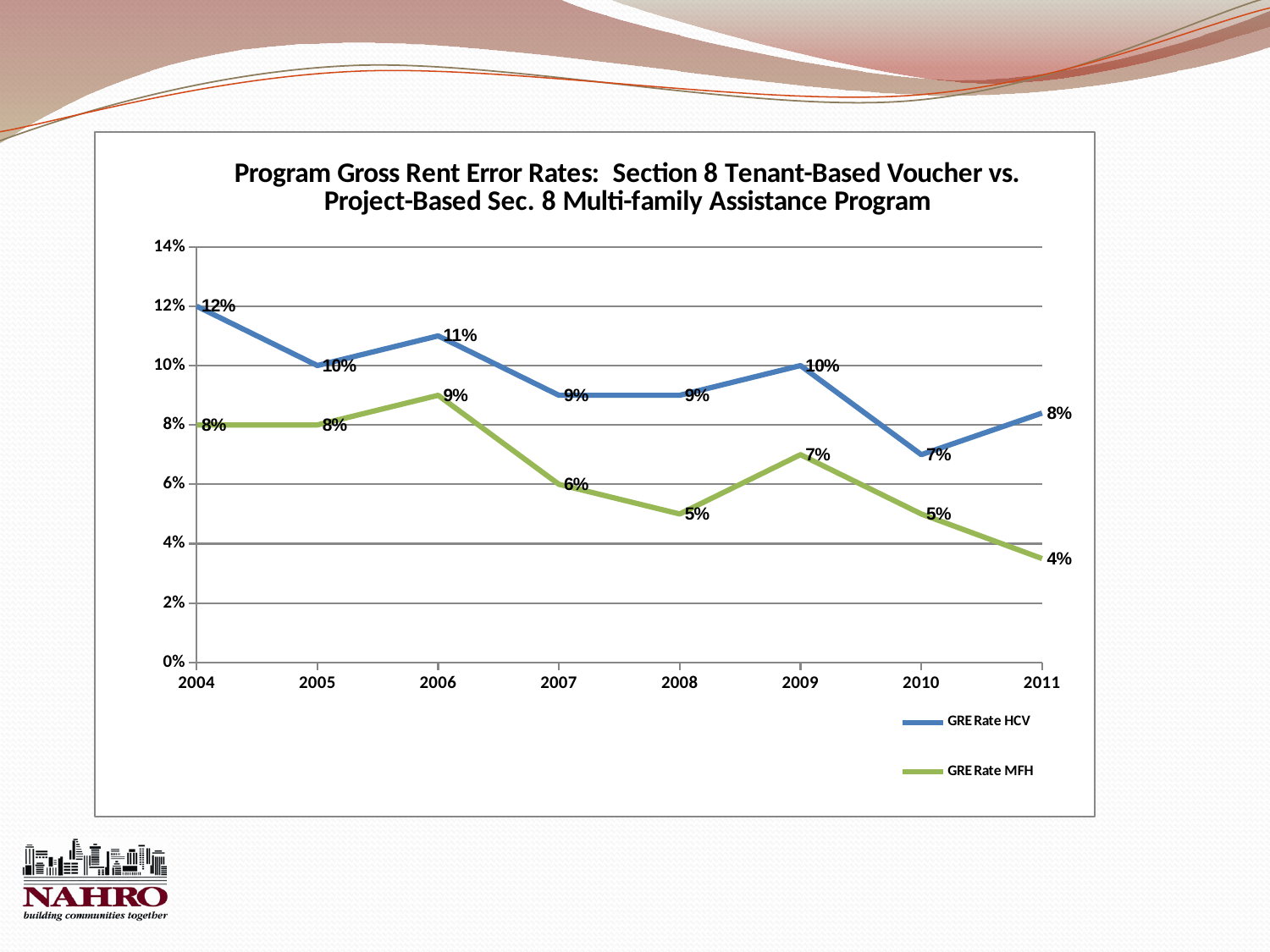
How many years are shown on the x axis? 8 Is the GRE Rate MFH value for 2009 greater or less than 8%? less How many series does the legend list? 2 What kind of chart is shown on the slide? line chart Which series has the larger value in 2006, GRE Rate HCV or GRE Rate MFH? GRE Rate HCV In which year is the GRE Rate MFH lowest? 2011 What is the GRE Rate HCV value for 2004? 12% Does the GRE Rate MFH generally rise or fall from 2004 to 2011? fall In which year is the GRE Rate HCV highest? 2004 What is the GRE Rate HCV value for 2010? 7% What is the GRE Rate MFH value for 2008? 5% What is the difference between the GRE Rate HCV and GRE Rate MFH values in 2011? 4%